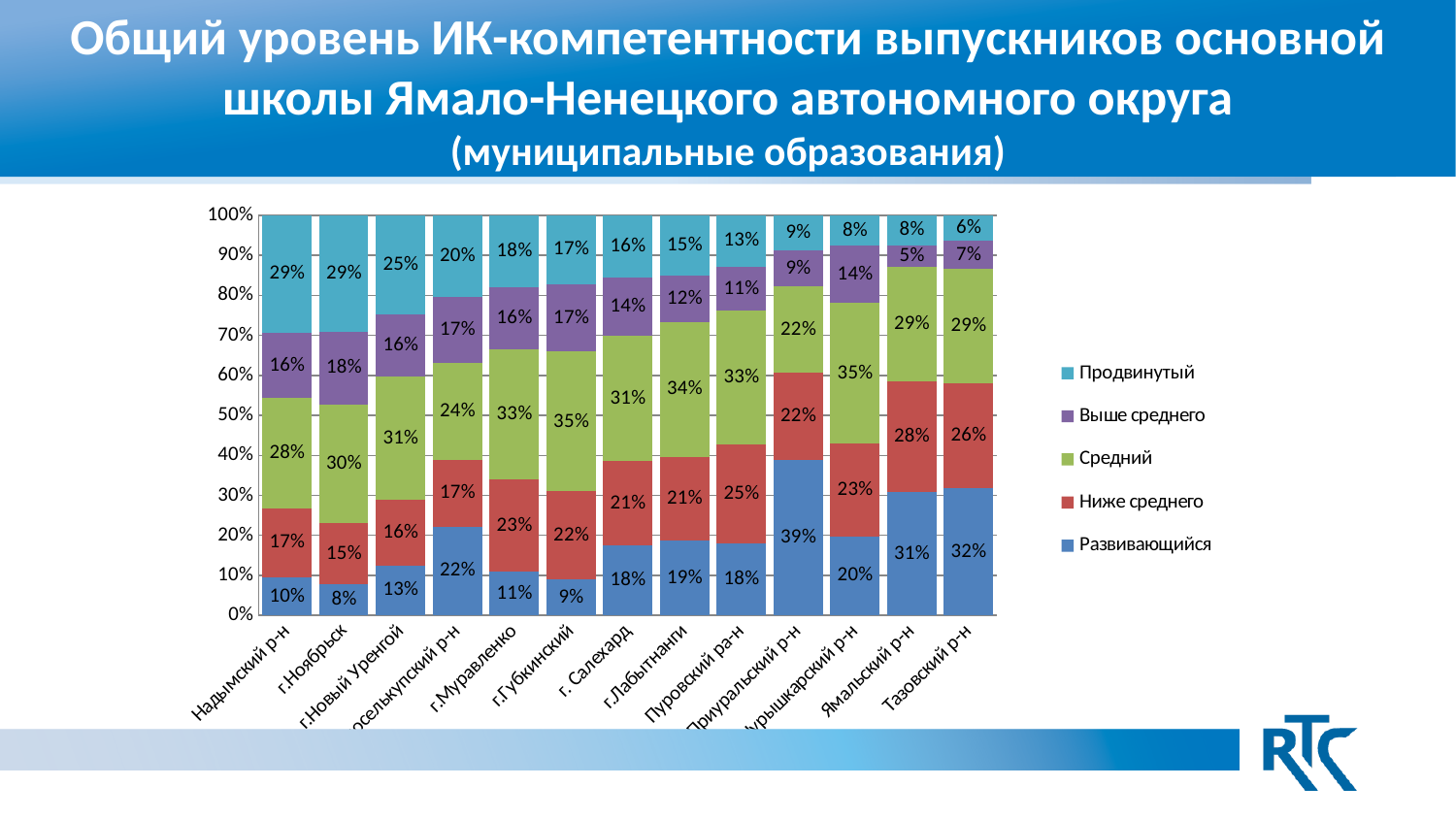
How many series does the legend list? 5 What is the value of the Средний series for г.Губкинский? 35% Which series is shown in the topmost segment of each bar, according to the legend? Продвинутый What is the value of the Продвинутый series for Надымский р-н? 29% What is the value of the Развивающийся series for Приуральский р-н? 39% What kind of chart is shown on the slide? Stacked bar chart How many municipalities (categories) are shown on the x axis? 13 What is the difference between the Продвинутый values for г.Ноябрьск and г.Лабытнанги? 14% Which is larger: the Выше среднего value for г.Ноябрьск or for Ямальский р-н? г.Ноябрьск What is the value of the Ниже среднего series for Пуровский ра-н? 25% Which municipality has the highest value for the Развивающийся series? Приуральский р-н Which municipality has the lowest value for the Продвинутый series? Тазовский р-н